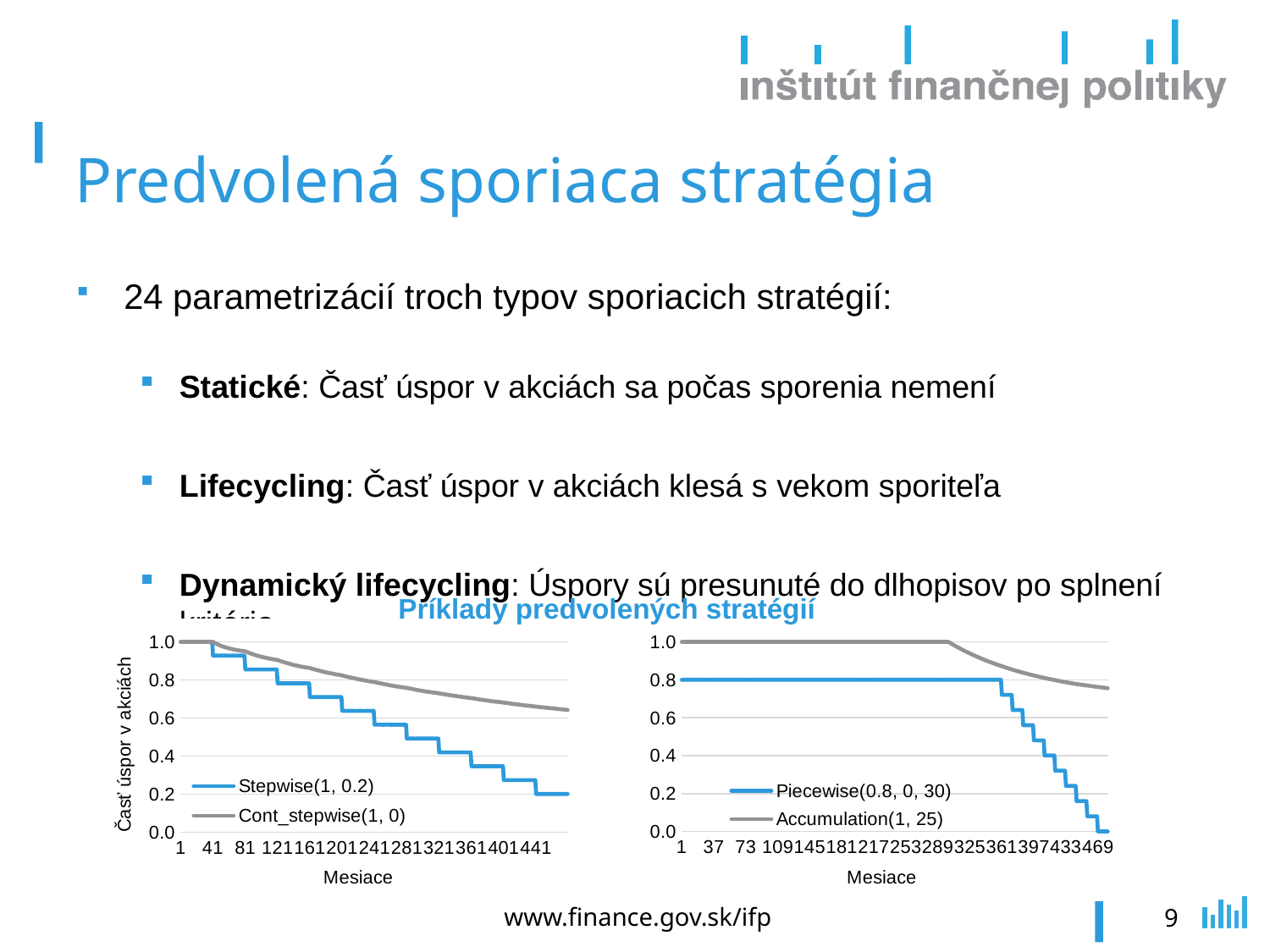
In the left chart, what is the value of Stepwise(1, 0.2) at month 1? 1.0 In the right chart, which series has the higher value at month 1, Piecewise(0.8, 0, 30) or Accumulation(1, 25)? Accumulation(1, 25) What kind of chart is the left chart on the slide? line chart How many series does the legend of the right chart list? 2 In the left chart, is the value of Cont_stepwise(1, 0) at month 441 greater or less than 0.6? greater How many series does the legend of the left chart list? 2 In the right chart, what is the value of Accumulation(1, 25) at month 1? 1.0 In the right chart, does the Piecewise(0.8, 0, 30) series rise or fall over the months shown? fall In the left chart, does the Cont_stepwise(1, 0) series rise or fall along the x axis? fall In the right chart, what is the value of Piecewise(0.8, 0, 30) at month 1? 0.8 What is the title shown above the two charts? Príklady predvolených stratégií In the left chart, is the value of Stepwise(1, 0.2) at month 441 greater or less than 0.4? less